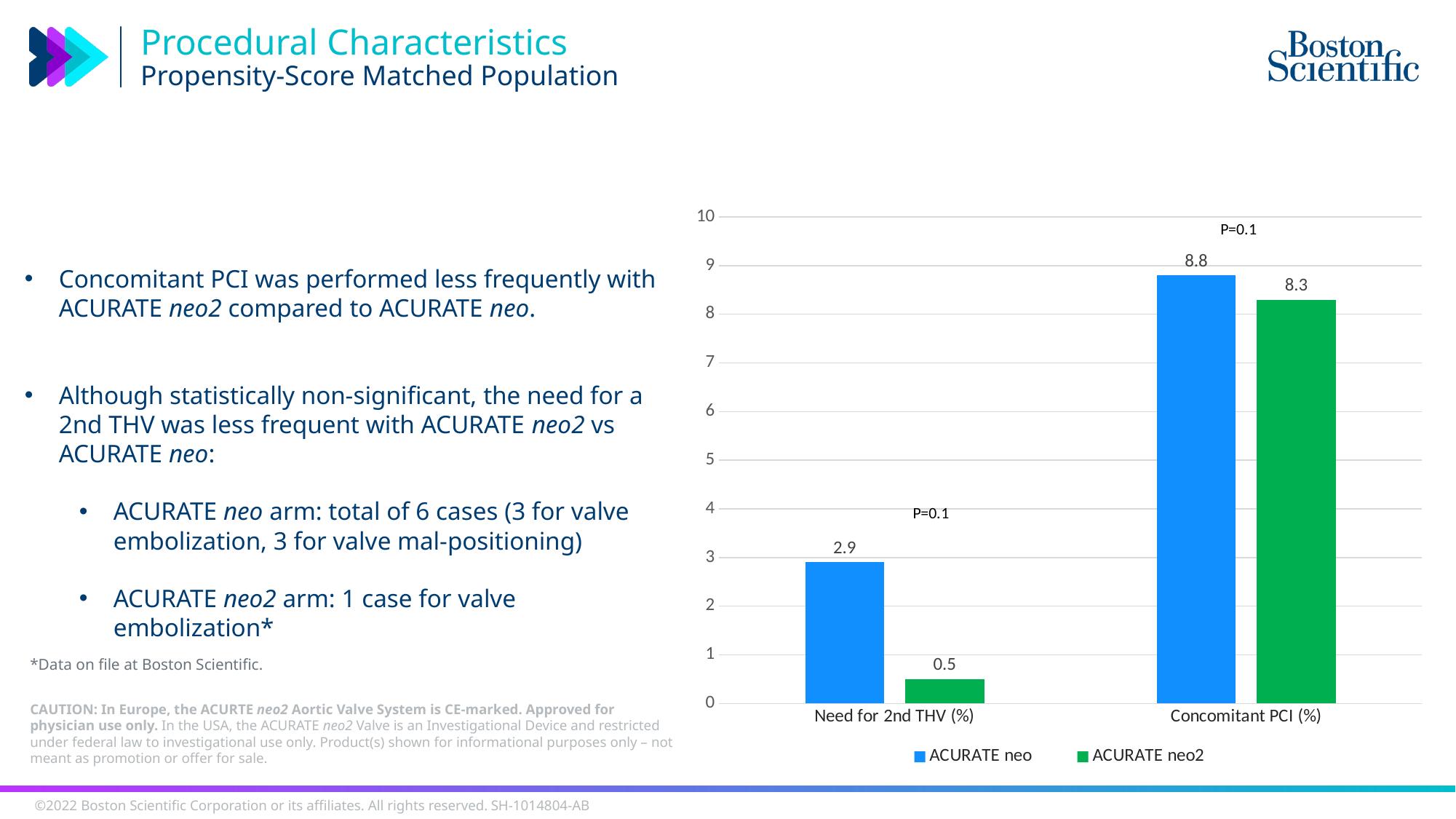
What kind of chart is shown on the slide? Bar chart Which is larger in the Concomitant PCI (%) category: ACURATE neo or ACURATE neo2? ACURATE neo How many categories are shown on the x axis of the chart? 2 What is the value for ACURATE neo2 in the Need for 2nd THV (%) category? 0.5 What is the value for ACURATE neo2 in the Concomitant PCI (%) category? 8.3 How many series does the chart legend list? 2 Which series has the lowest value in the Need for 2nd THV (%) category? ACURATE neo2 What is the difference between ACURATE neo and ACURATE neo2 in the Concomitant PCI (%) category? 0.5 What is the difference between ACURATE neo and ACURATE neo2 in the Need for 2nd THV (%) category? 2.4 Which category has the highest value for ACURATE neo? Concomitant PCI (%) What is the value for ACURATE neo in the Concomitant PCI (%) category? 8.8 What is the value for ACURATE neo in the Need for 2nd THV (%) category? 2.9